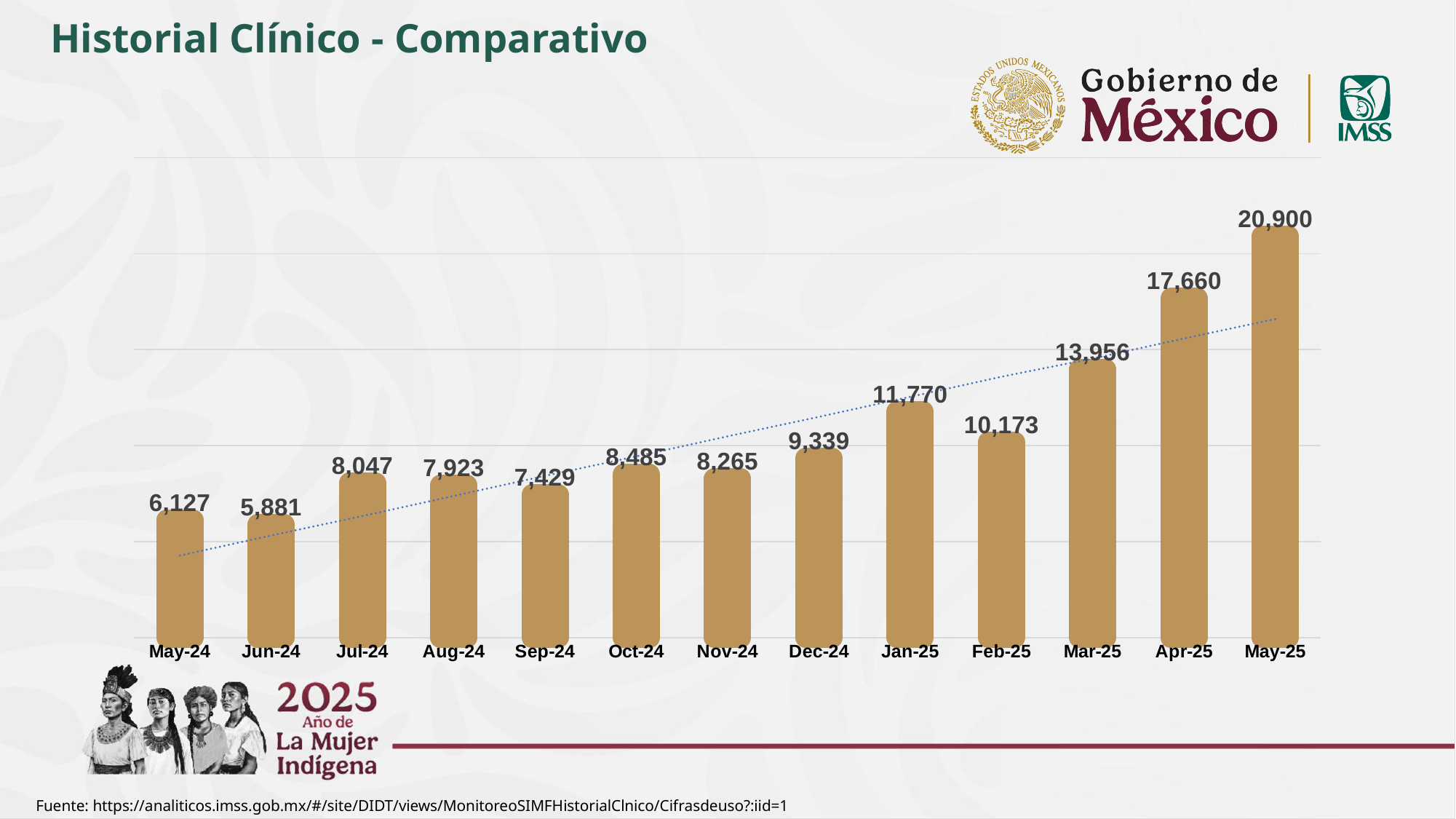
Which is larger, the value for Feb-25 or the value for Dec-24? Feb-25 What is the value for Mar-25? 13,956 What is the difference between the values for Jul-24 and Aug-24? 124 Do the values generally rise or fall from May-24 to May-25? Rise Which month has the highest value? May-25 What is the difference between the values for May-25 and Apr-25? 3,240 Which month has the lowest value? Jun-24 Which is larger, the value for Oct-24 or the value for Nov-24? Oct-24 What is the value for Jan-25? 11,770 What kind of chart is shown on the slide? Bar chart How many months are shown on the x axis? 13 What is the value for Sep-24? 7,429